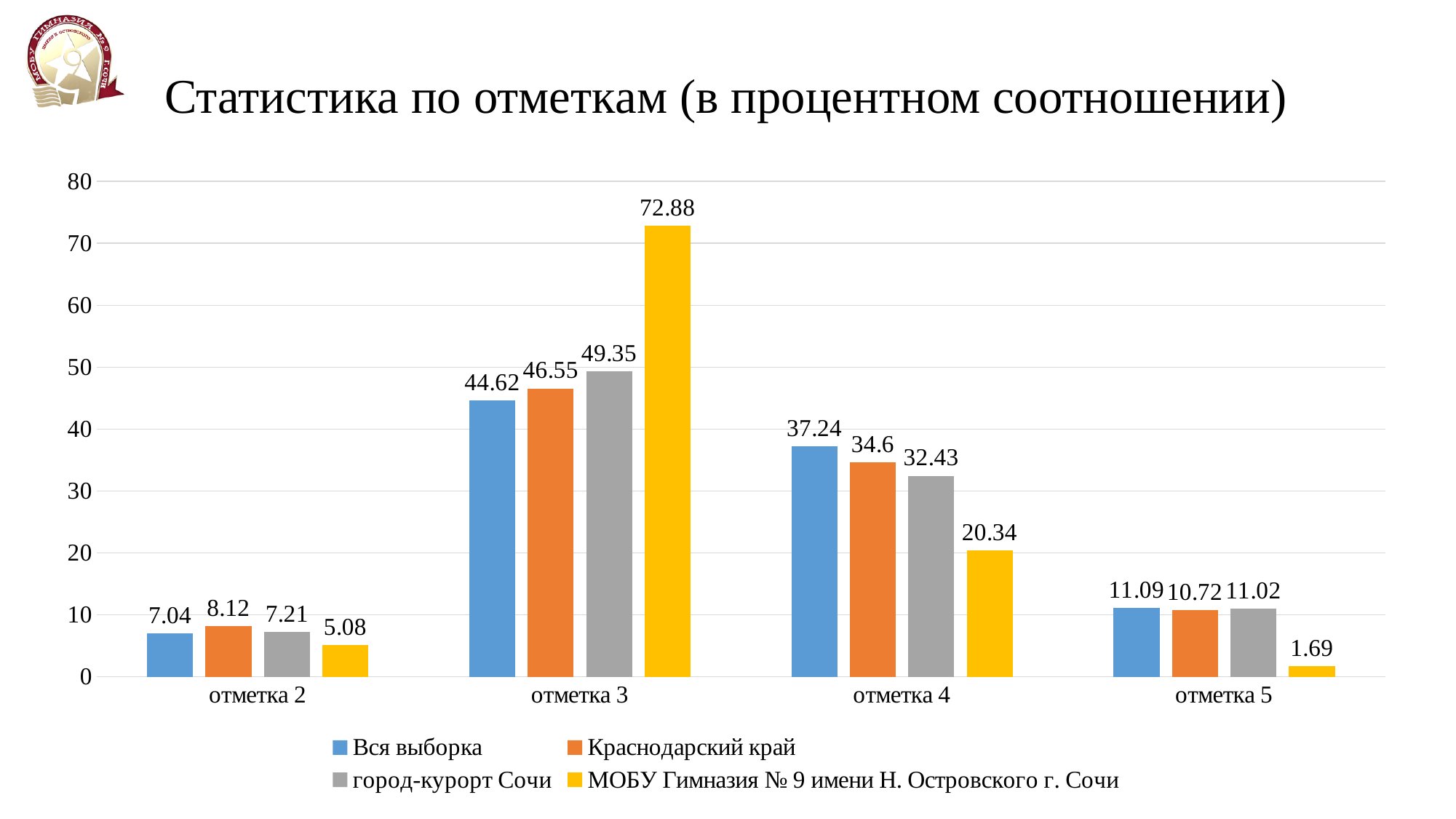
How many series does the legend list? 4 What kind of chart is shown on the slide? Bar chart What is the value for МОБУ Гимназия № 9 имени Н. Островского г. Сочи at отметка 3? 72.88 What is the value for Вся выборка at отметка 4? 37.24 What is the value for Краснодарский край at отметка 2? 8.12 How many categories are shown on the x axis? 4 What is the difference between the МОБУ Гимназия № 9 value and the Вся выборка value at отметка 3? 28.26 What is the title of the chart? Статистика по отметкам (в процентном соотношении) What is the value for город-курорт Сочи at отметка 5? 11.02 Which is larger at отметка 4: Краснодарский край or город-курорт Сочи? Краснодарский край Which series has the highest value at отметка 3? МОБУ Гимназия № 9 имени Н. Островского г. Сочи Which series has the lowest value at отметка 5? МОБУ Гимназия № 9 имени Н. Островского г. Сочи